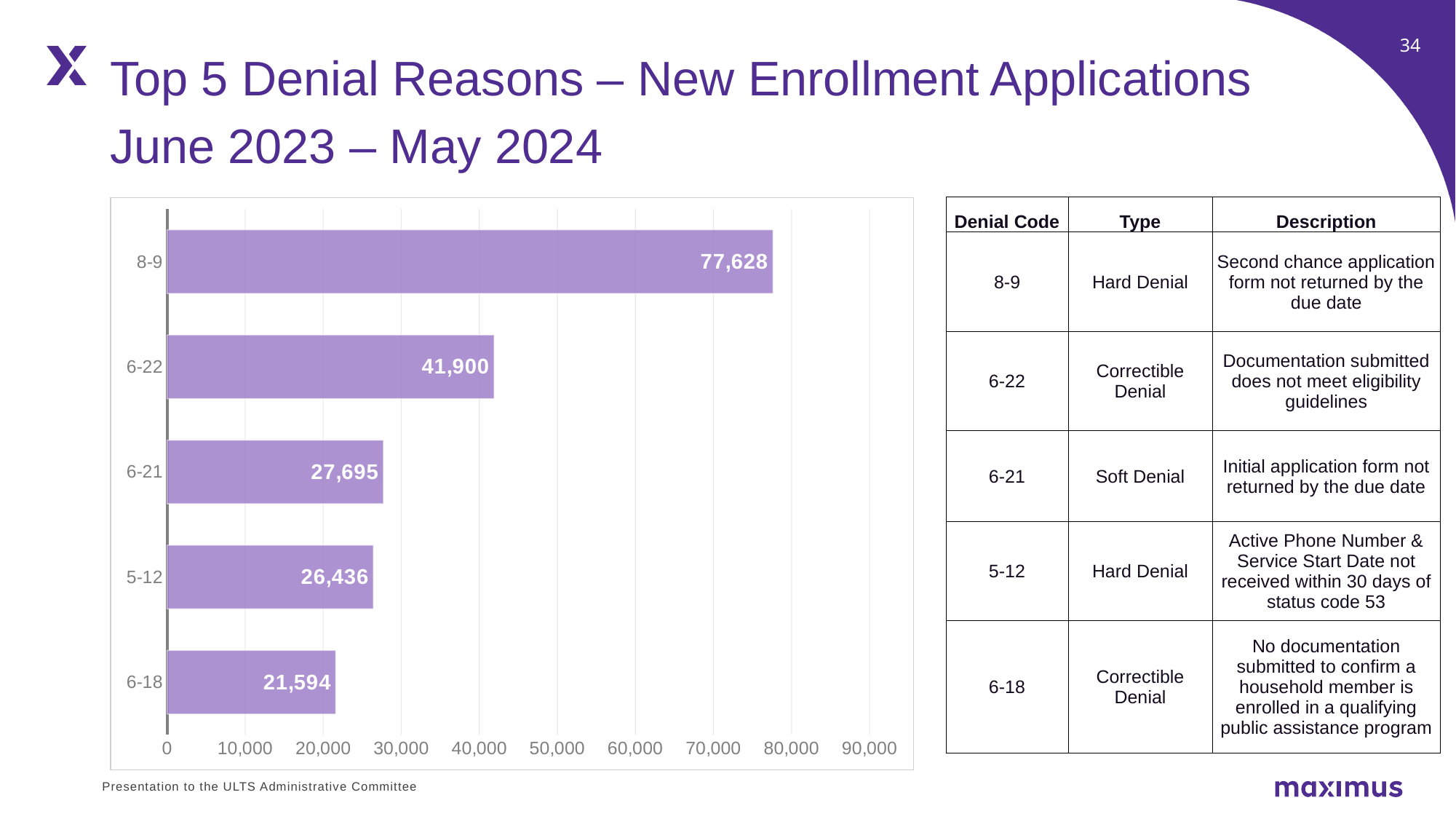
What is the difference between the values for 8-9 and 6-22? 35,728 What kind of chart is shown on the slide? bar chart Which denial code has the highest value? 8-9 How many denial codes are shown in the chart? 5 What is the value for denial code 5-12? 26,436 What is the value for denial code 6-18? 21,594 What is the value for denial code 6-22? 41,900 What is the difference between the values for 6-21 and 5-12? 1,259 Which has a larger value, 6-21 or 5-12? 6-21 What is the value for denial code 8-9? 77,628 Which denial code has the lowest value? 6-18 Is the value for 6-22 greater or less than 40,000? greater